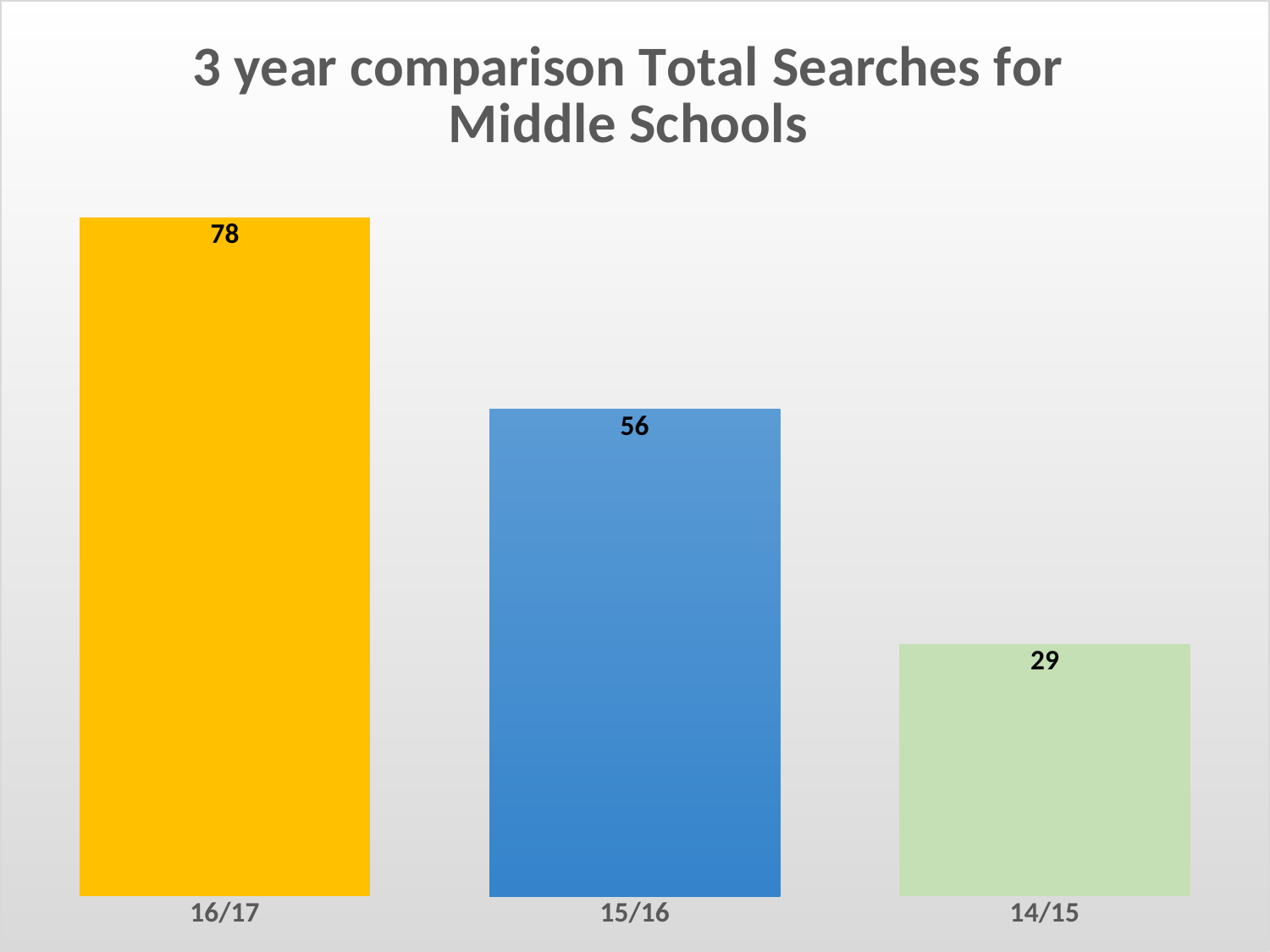
What is the value for 14/15? 29 What kind of chart is shown on the slide? bar chart How many categories are shown on the chart? 3 What is the value for 15/16? 56 Which year has the highest total searches? 16/17 Which year has the lowest total searches? 14/15 What is the difference between the values for 16/17 and 15/16? 22 What is the title of the chart? 3 year comparison Total Searches for Middle Schools Which is larger, the value for 15/16 or the value for 14/15? 15/16 Do the values rise or fall from left to right along the x axis? fall What is the value for 16/17? 78 What is the difference between the values for 15/16 and 14/15? 27